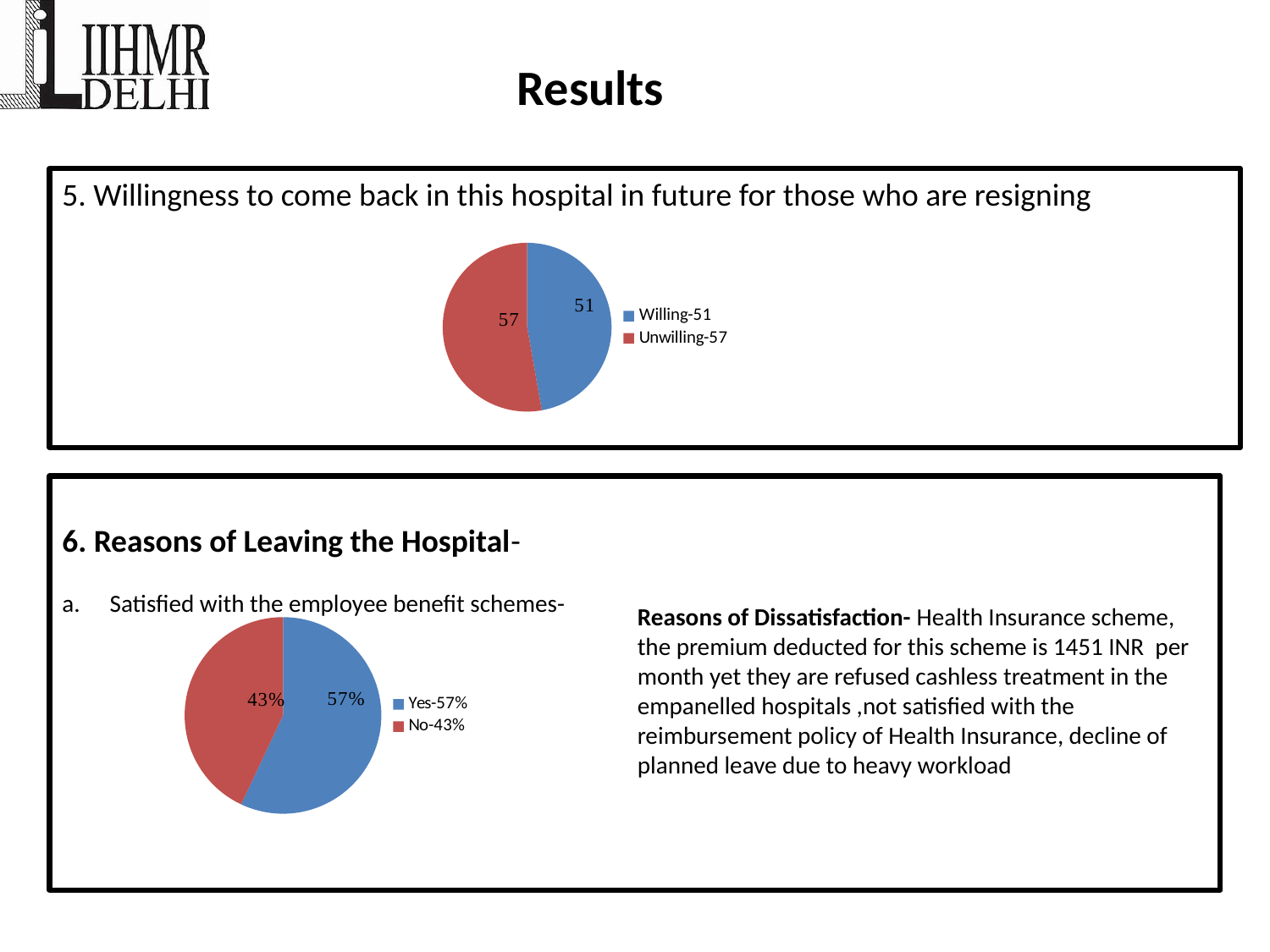
What type of chart is used in the top box about willingness to come back to the hospital? Pie chart In the top pie chart about willingness to come back to the hospital, what is the total of the two slices? 108 In the top pie chart about willingness to come back to the hospital, what value is shown for Willing? 51 In the bottom pie chart about satisfaction with employee benefit schemes, what colour is the No slice? Red In the bottom pie chart about satisfaction with employee benefit schemes, which slice is the largest? Yes In the top pie chart about willingness to come back to the hospital, how many slices does the pie have? 2 In the top pie chart about willingness to come back to the hospital, which slice is larger, Willing or Unwilling? Unwilling In the bottom pie chart about satisfaction with employee benefit schemes, what share is shown for No? 43% In the bottom pie chart about satisfaction with employee benefit schemes, what is the difference between the Yes and No shares? 14% In the top pie chart about willingness to come back to the hospital, what is the difference between the Unwilling and Willing values? 6 In the bottom pie chart about satisfaction with employee benefit schemes, what share is shown for Yes? 57% In the top pie chart about willingness to come back to the hospital, what value is shown for Unwilling? 57